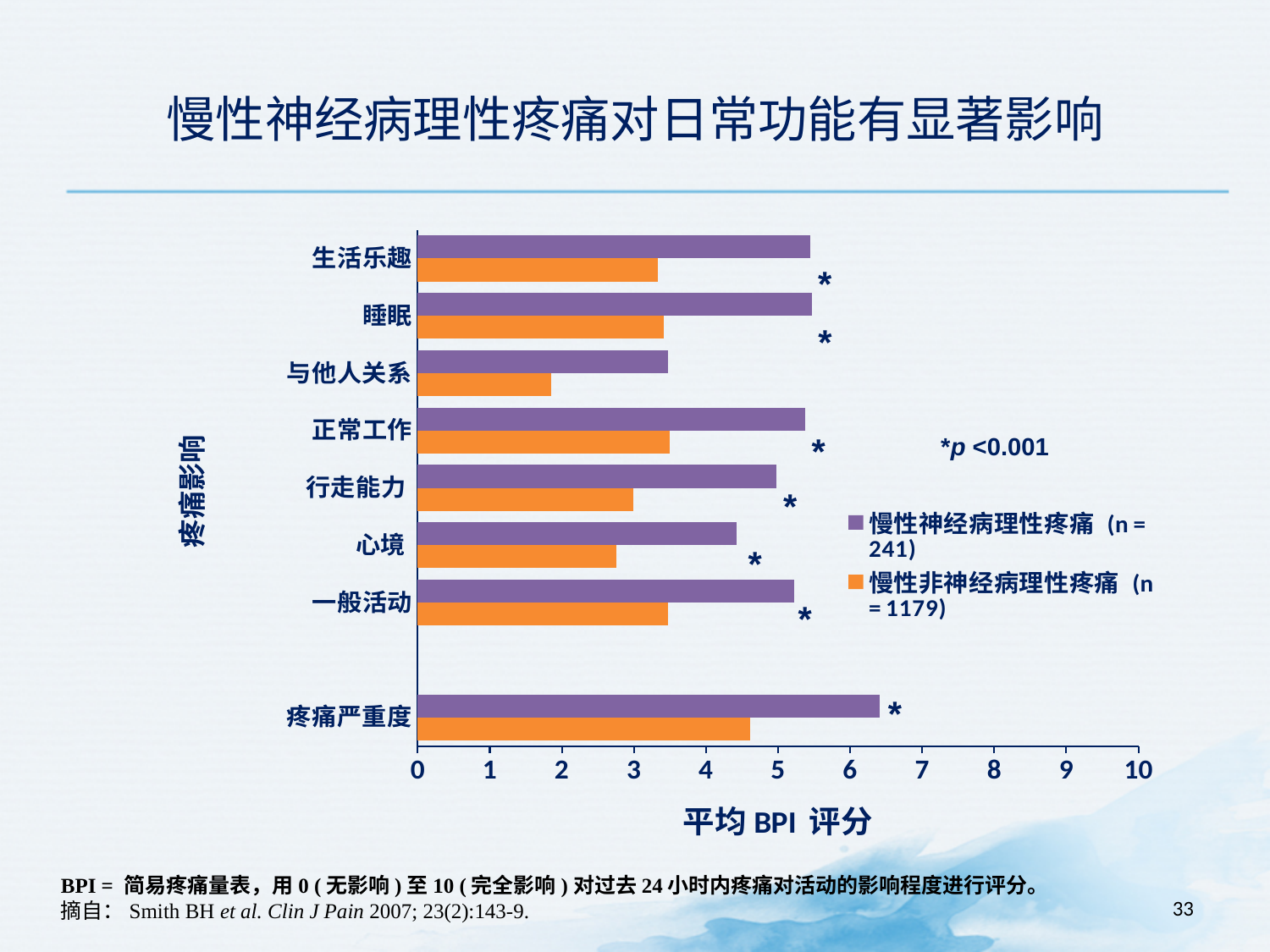
Is the value for 与他人关系 in the 慢性非神经病理性疼痛 (n = 1179) series greater or less than 2? less Which category has the lowest value for 慢性神经病理性疼痛 (n = 241)? 与他人关系 Is the value for 疼痛严重度 in the 慢性神经病理性疼痛 (n = 241) series greater or less than 6? greater How many series does the legend list? 2 Is the value for 心境 in the 慢性神经病理性疼痛 (n = 241) series greater or less than 5? less What colour are the bars for the 慢性非神经病理性疼痛 (n = 1179) series? orange What is the label of the x axis of the chart? 平均 BPI 评分 For 睡眠, which series has the larger value: 慢性神经病理性疼痛 (n = 241) or 慢性非神经病理性疼痛 (n = 1179)? 慢性神经病理性疼痛 (n = 241) What kind of chart is shown on the slide? bar chart How many categories are plotted on the y axis of the chart? 8 Which category has the lowest value for 慢性非神经病理性疼痛 (n = 1179)? 与他人关系 Which category has the highest value for 慢性神经病理性疼痛 (n = 241)? 疼痛严重度